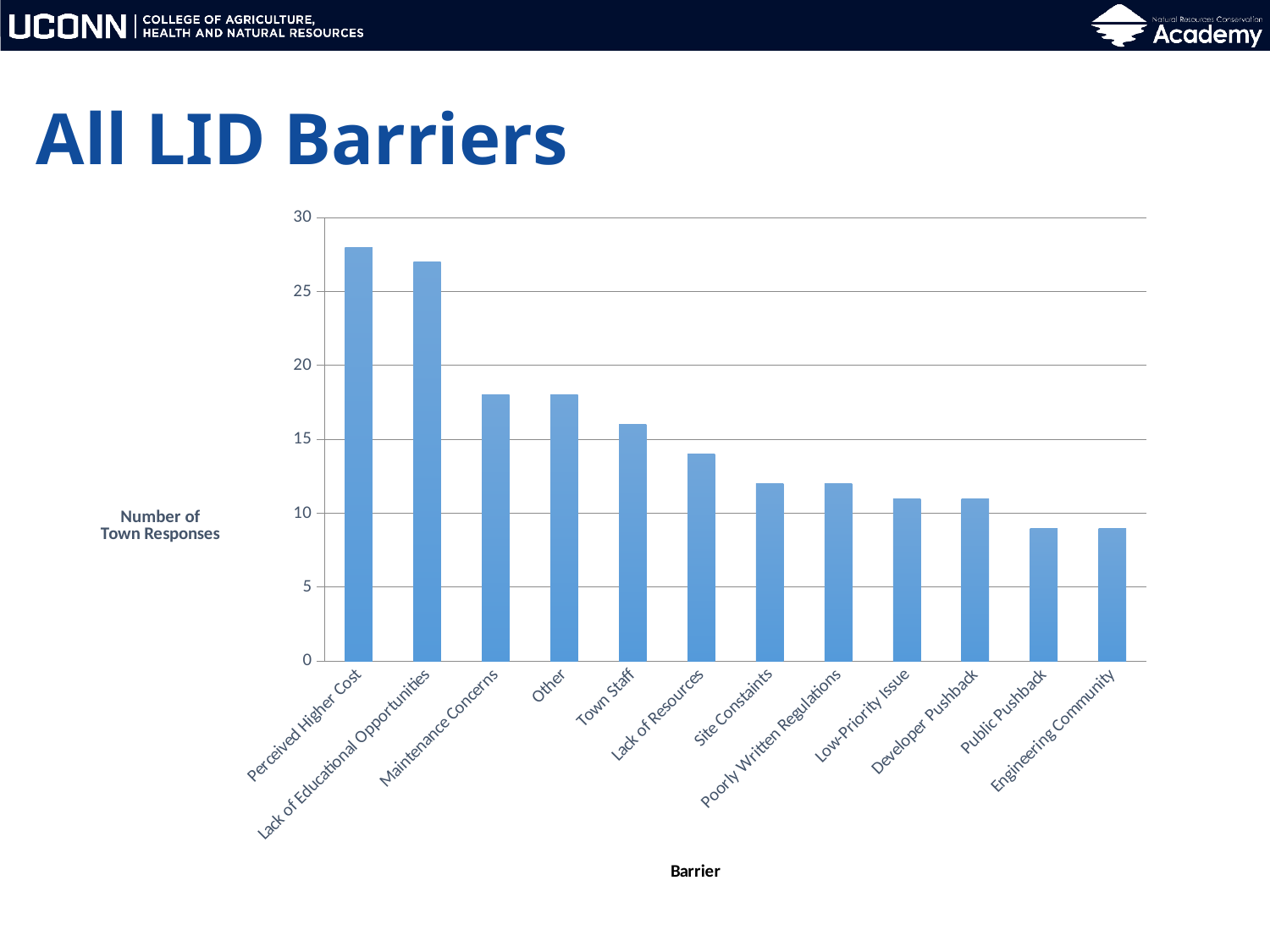
How many barrier categories are plotted on the chart? 12 Is the value for Maintenance Concerns greater or less than 20? less Is the value for Town Staff greater or less than 15? greater Which has more town responses, Site Constaints or Perceived Higher Cost? Perceived Higher Cost Is the value for Perceived Higher Cost greater or less than 25? greater Which has more town responses, Maintenance Concerns or Town Staff? Maintenance Concerns Do the values rise or fall moving from left to right along the x axis? Fall Which barrier has the highest number of town responses? Perceived Higher Cost What is the label on the x axis of the chart? Barrier What kind of chart is shown on the slide? Bar chart